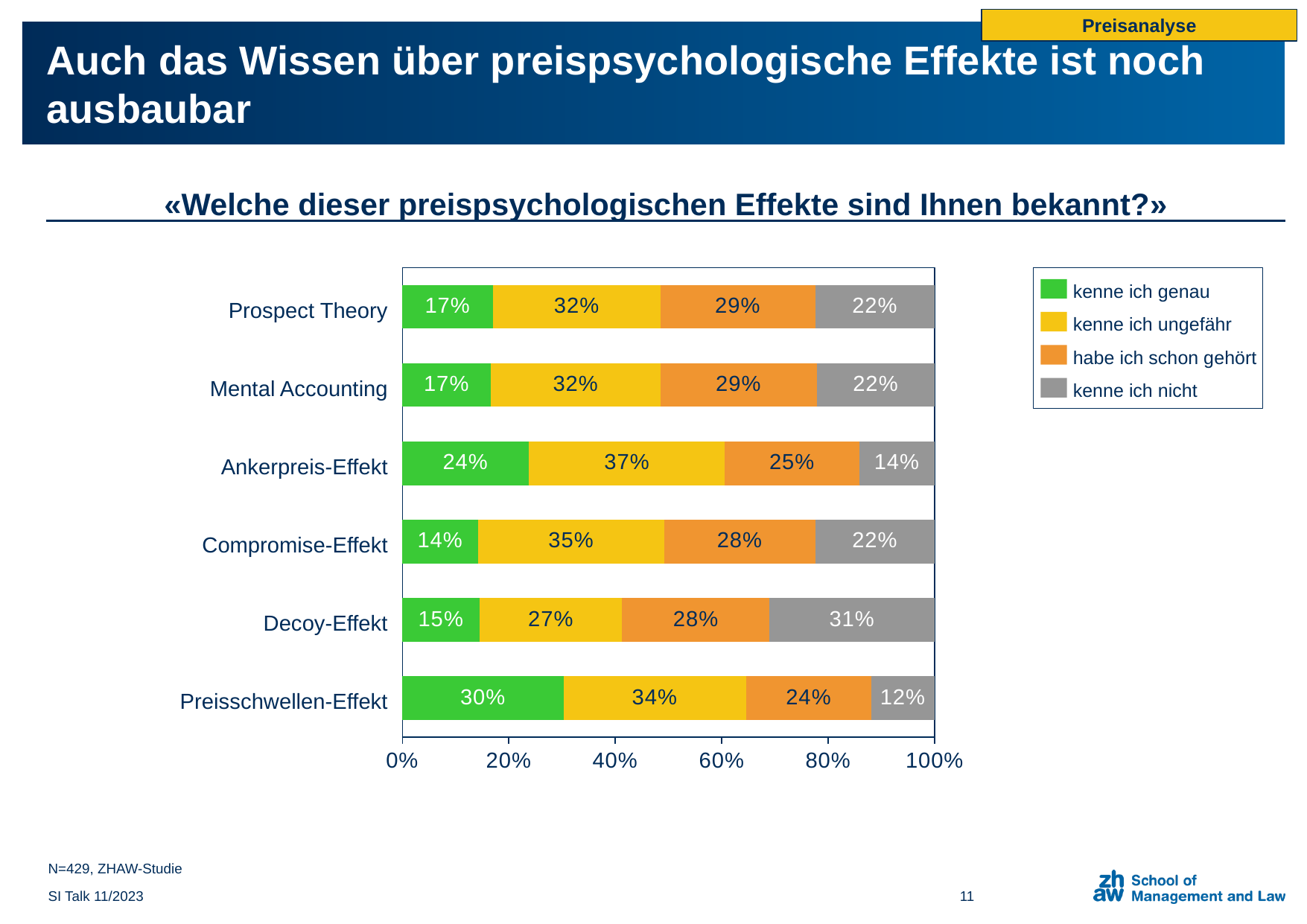
How many price-psychology effects are listed on the chart? 6 How many percentage points higher is the "kenne ich ungefähr" value for Ankerpreis-Effekt than for Decoy-Effekt? 10 percentage points What is the "habe ich schon gehört" value for Compromise-Effekt? 28% Which effect has the lowest "kenne ich nicht" share? Preisschwellen-Effekt Which has the larger "kenne ich genau" value: Compromise-Effekt or Decoy-Effekt? Decoy-Effekt How many response categories does the legend list? 4 Which effect has the highest "kenne ich nicht" share? Decoy-Effekt Which effect has the highest "kenne ich genau" share? Preisschwellen-Effekt What percentage of respondents answered "kenne ich genau" for Preisschwellen-Effekt? 30% What kind of chart is shown on the slide? Stacked bar chart What is the total of the stacked bar for Prospect Theory? 100% What is the "kenne ich nicht" value for Decoy-Effekt? 31%